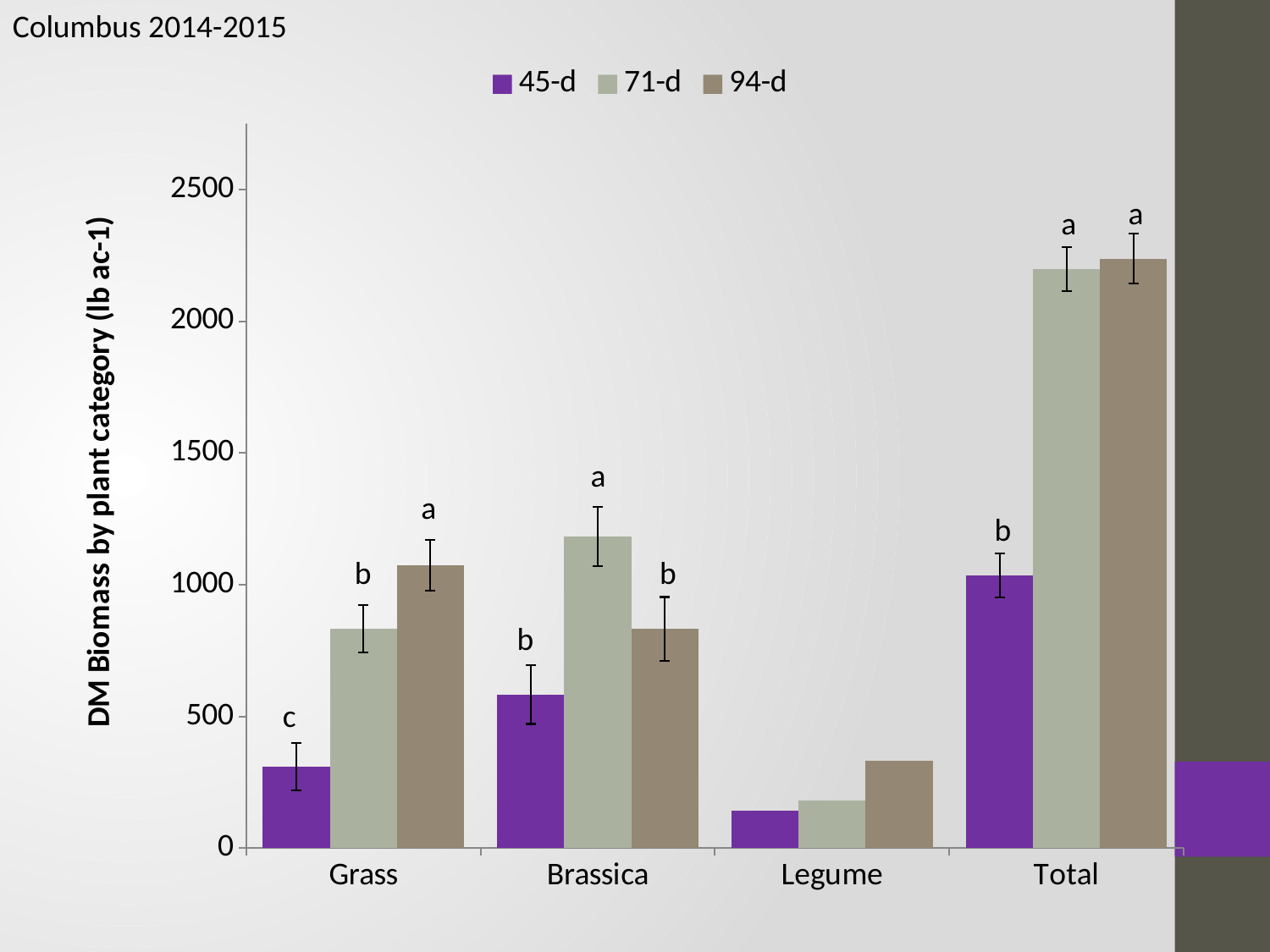
Is the 71-d value for Total greater or less than 2000? greater How many plant categories are shown on the x axis? 4 Is the 94-d value for Grass greater or less than 1000? greater What is the label on the y axis? DM Biomass by plant category (lb ac-1) Is the 94-d value for Legume greater or less than 500? less What kind of chart is shown on the slide? bar chart In the Brassica category, which is larger: the 71-d bar or the 94-d bar? 71-d What letter is printed above the 45-d bar for Grass? c Which series has the tallest bar in the Grass category? 94-d Which plant category has the lowest 45-d bar? Legume How many series does the legend list? 3 Which series has the tallest bar in the Brassica category? 71-d